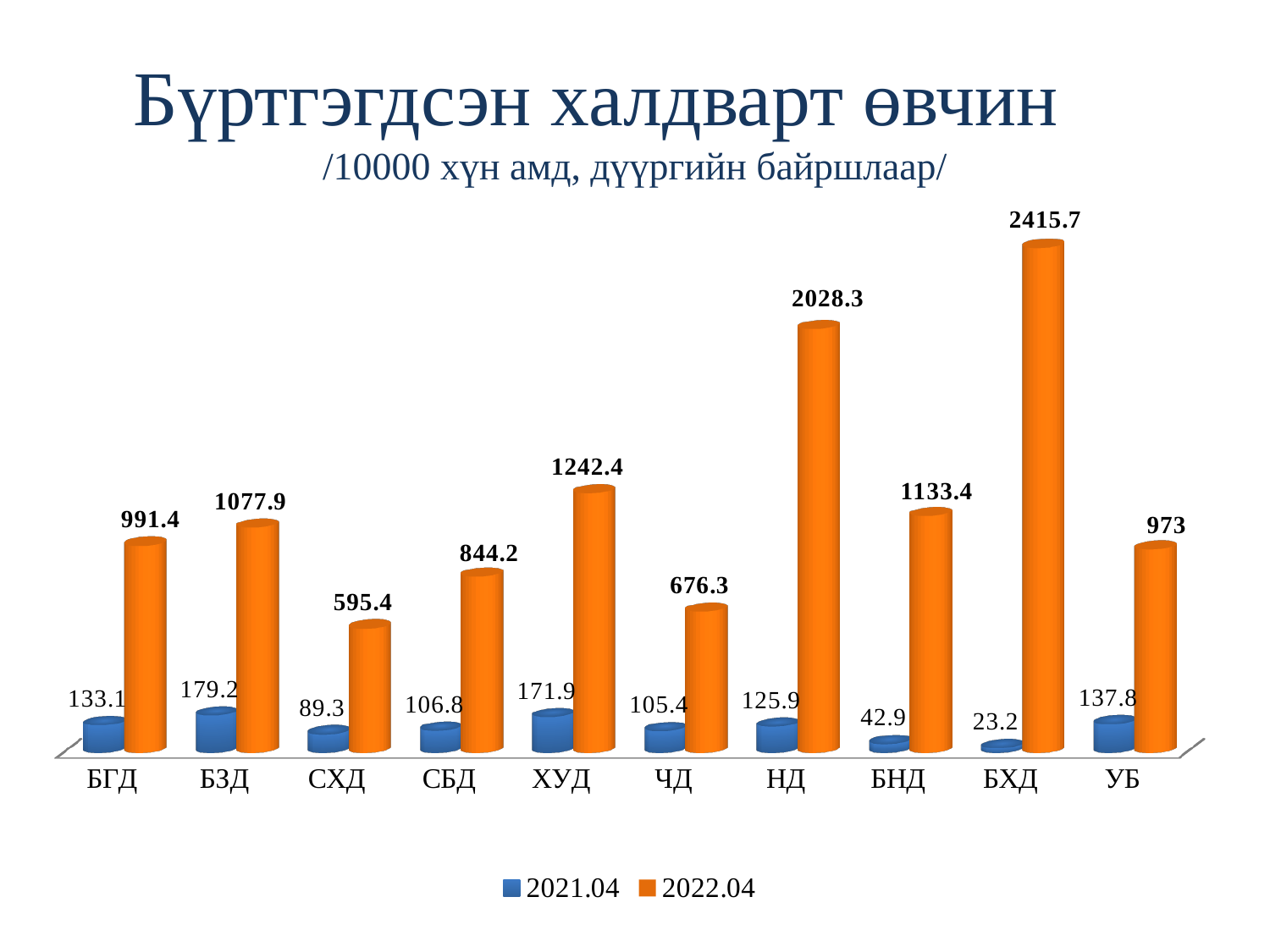
Which series is shown in orange according to the legend? 2022.04 What is the value for БЗД in the 2021.04 series? 179.2 How many series does the legend list? 2 Which category has the lowest value in the 2022.04 series? СХД What kind of chart is shown on the slide? Bar chart What is the difference between the 2022.04 and 2021.04 values for НД? 1902.4 Which category has the lowest value in the 2021.04 series? БХД Which category has the highest value in the 2022.04 series? БХД How many categories are shown on the x axis? 10 Which is larger: the 2022.04 value for БЗД or the 2022.04 value for БНД? БНД What is the value for УБ in the 2022.04 series? 973 What is the value for БХД in the 2022.04 series? 2415.7